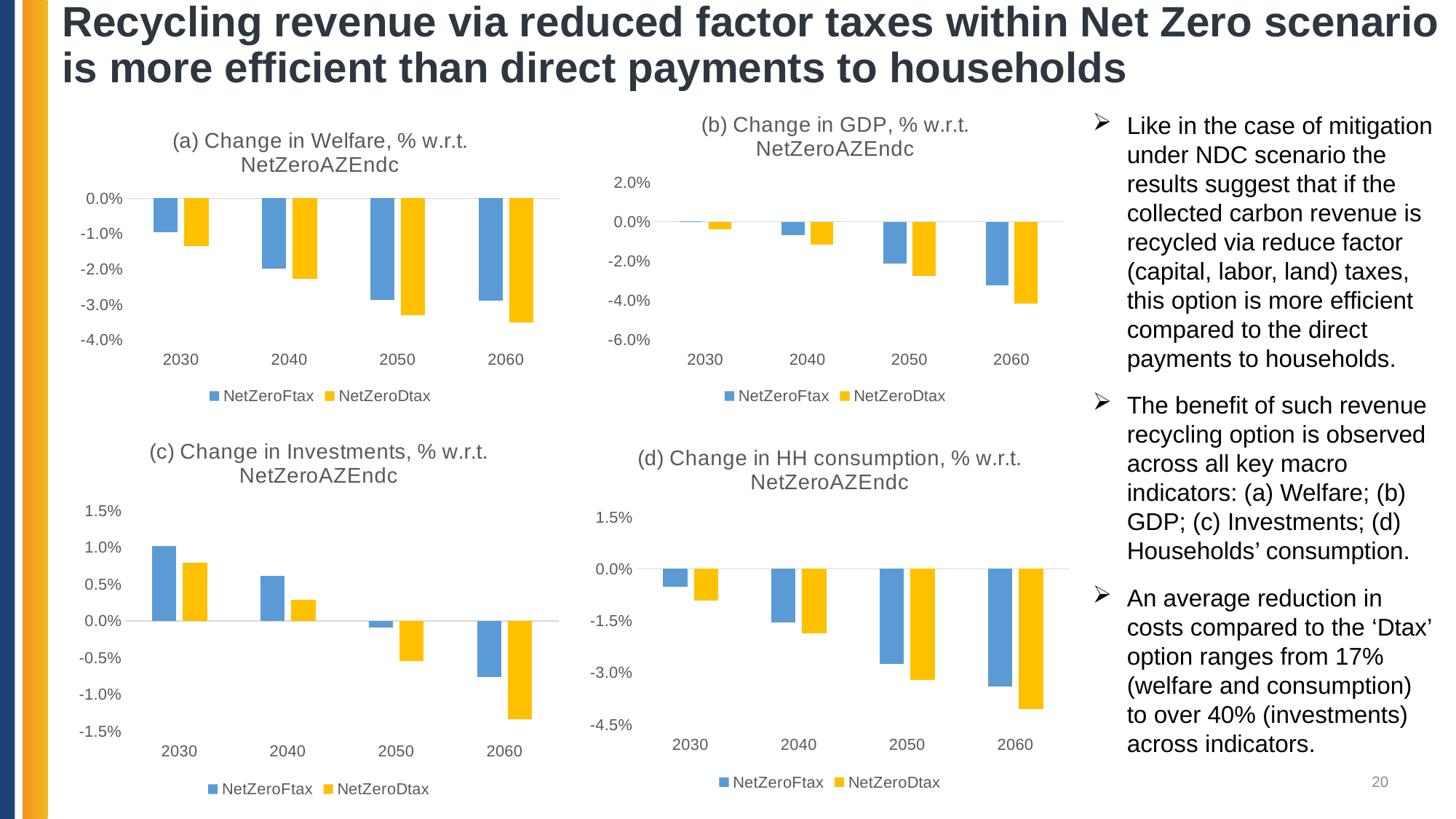
In chart (a) Change in Welfare, is the NetZeroDtax value for 2060 greater or less than -3.0%? less In chart (b) Change in GDP, how many series does the legend list? 2 In chart (a) Change in Welfare, what colour represents the NetZeroDtax series? yellow In chart (c) Change in Investments, how many years are shown on the x axis? 4 In chart (d) Change in HH consumption, do the NetZeroFtax values rise or fall from 2030 to 2060? fall In chart (c) Change in Investments, which year has the highest NetZeroFtax value? 2030 In chart (b) Change in GDP, is the NetZeroFtax value for 2060 greater or less than -2.0%? less In chart (c) Change in Investments, is the NetZeroFtax value for 2030 greater or less than 0.5%? greater In chart (b) Change in GDP, which year has the lowest NetZeroDtax value? 2060 In chart (c) Change in Investments, which series has the larger value in 2030, NetZeroFtax or NetZeroDtax? NetZeroFtax What kind of chart is chart (a) Change in Welfare? bar chart